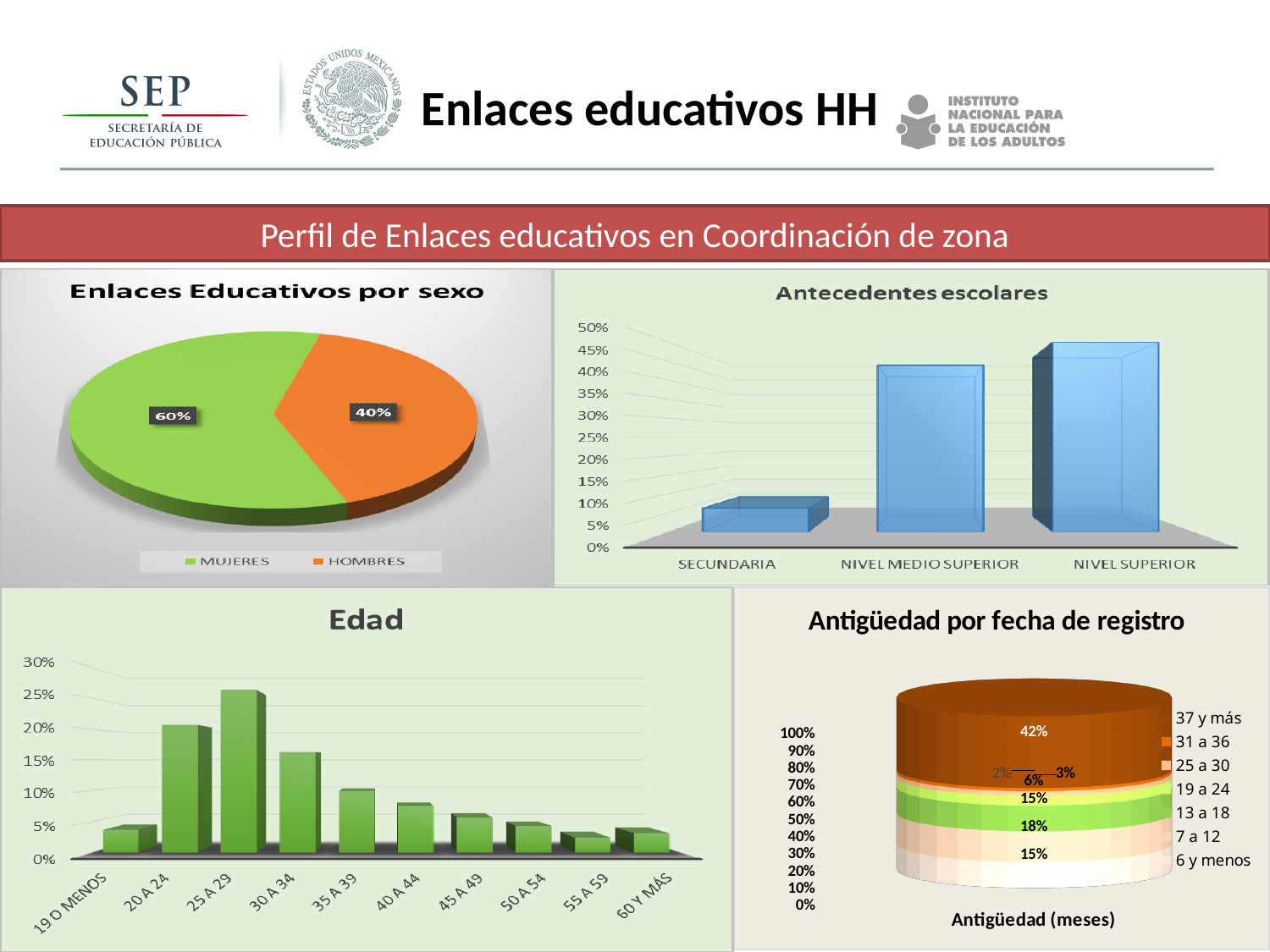
In the 'Enlaces Educativos por sexo' chart, what share of the pie is MUJERES? 60% How many age categories are shown in the 'Edad' chart? 10 In the 'Antecedentes escolares' chart, is the value for NIVEL SUPERIOR greater or less than 40%? greater What kind of chart is 'Enlaces Educativos por sexo'? pie chart In the 'Edad' chart, which age group has the highest value? 25 A 29 In the 'Enlaces Educativos por sexo' chart, what is the difference between MUJERES and HOMBRES? 20% In the 'Enlaces Educativos por sexo' chart, what is the value for HOMBRES? 40% How many entries does the legend of the 'Antigüedad por fecha de registro' chart list? 7 In the 'Edad' chart, which is larger, the value for 30 A 34 or for 35 A 39? 30 A 34 In the 'Antecedentes escolares' chart, which category has the highest value? NIVEL SUPERIOR In the 'Antigüedad por fecha de registro' chart, what is the value for '37 y más'? 42% In the 'Antecedentes escolares' chart, is the value for SECUNDARIA greater or less than 10%? less